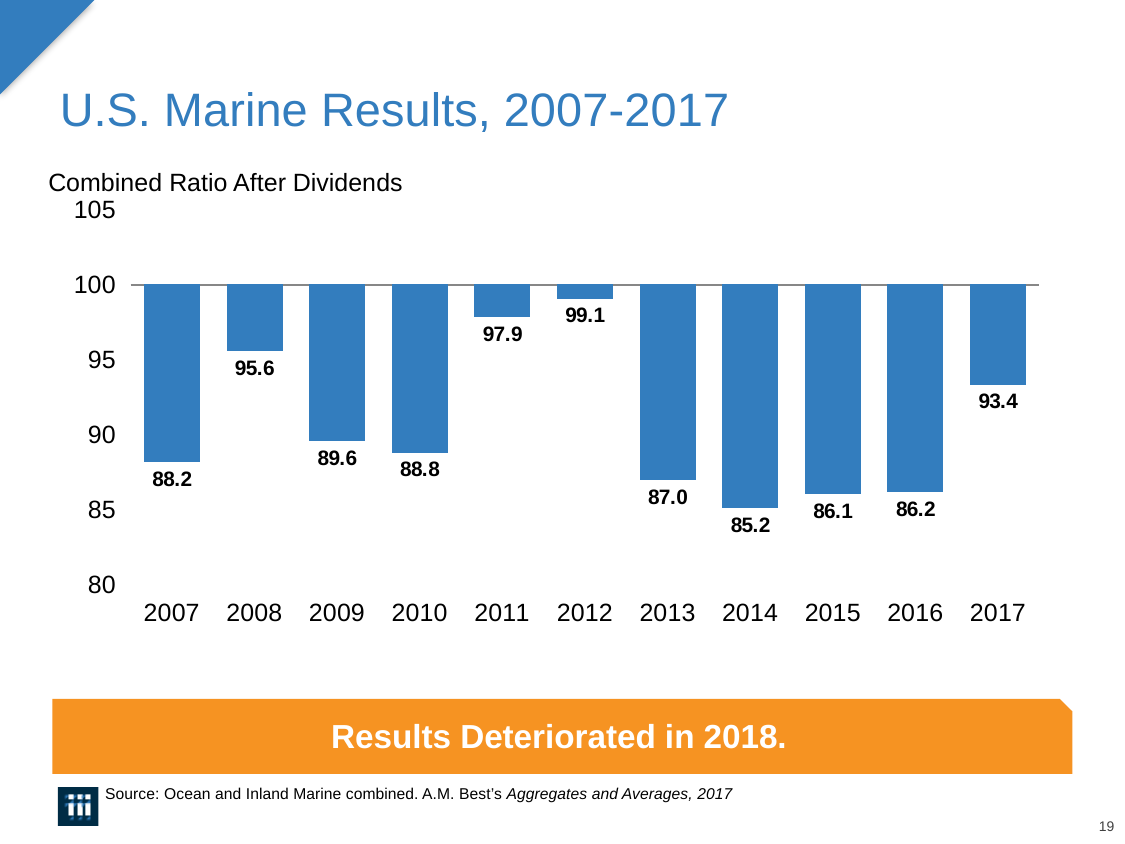
Does the combined ratio rise or fall from 2012 to 2014? fall What is the combined ratio after dividends for 2014? 85.2 Is the combined ratio for 2013 greater or less than 90? less What is the combined ratio after dividends for 2017? 93.4 Which year has the lowest combined ratio after dividends? 2014 How many years are shown on the chart? 11 What is the difference between the combined ratio in 2012 and in 2014? 13.9 What is the title of the chart? U.S. Marine Results, 2007-2017 What kind of chart is shown on the slide? bar chart Which year has the highest combined ratio after dividends? 2012 What is the combined ratio after dividends for 2007? 88.2 Which year has a higher combined ratio, 2008 or 2011? 2011